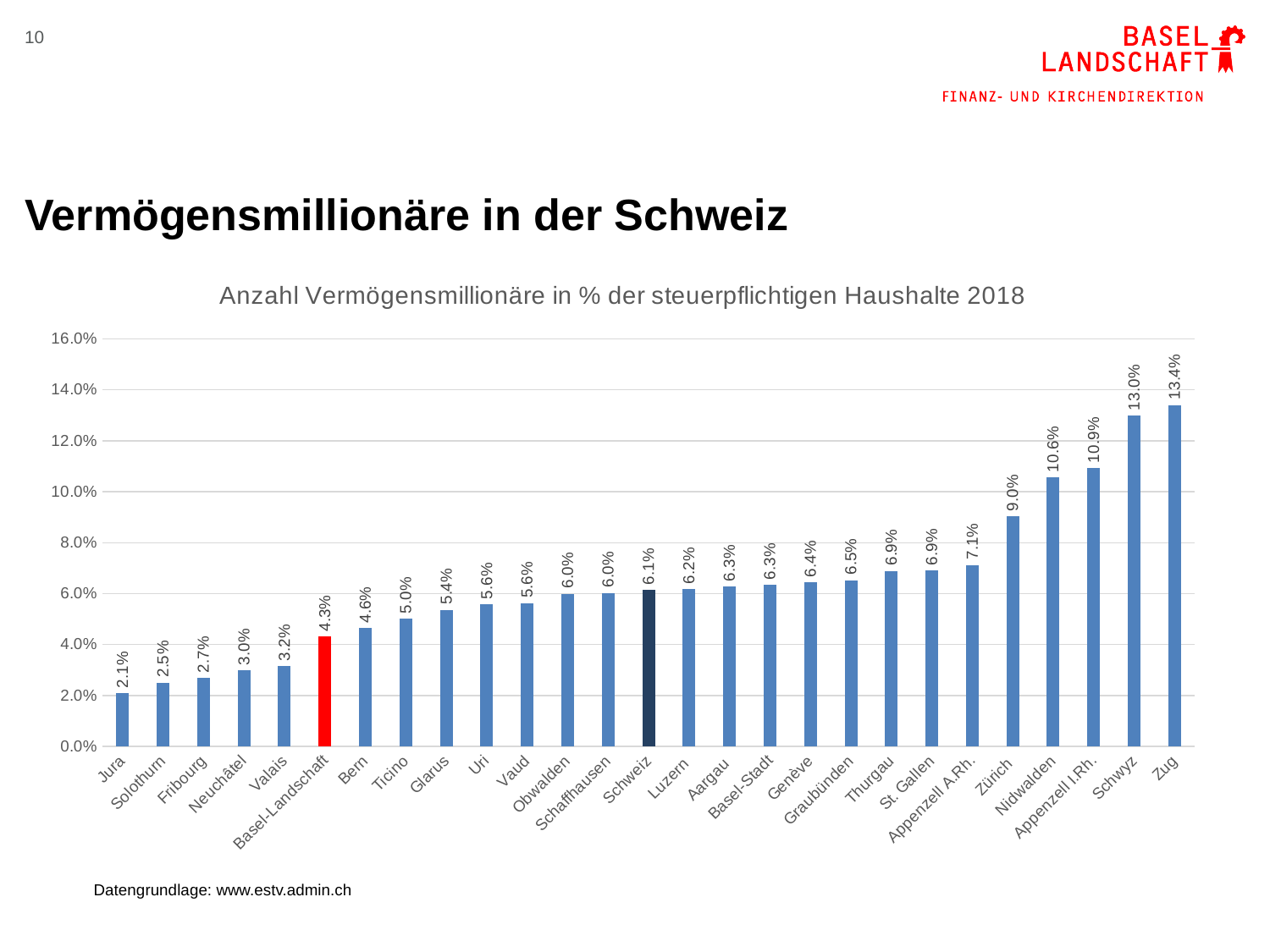
What kind of chart is shown on the slide? Bar chart Which bar is highlighted in red? Basel-Landschaft What is the value for Schweiz? 6.1% Which canton has the lowest share of wealth millionaires? Jura How many bars are shown in the chart? 27 Is the value for Appenzell I.Rh. greater or less than 10.0%? greater What is the value for Basel-Landschaft? 4.3% What is the difference between the values for Zug and Jura? 11.3% Which canton has the highest share of wealth millionaires? Zug Which is larger, the value for Schwyz or the value for Nidwalden? Schwyz What is the value for Zürich? 9.0% What is the difference between the values for Schweiz and Basel-Landschaft? 1.8%